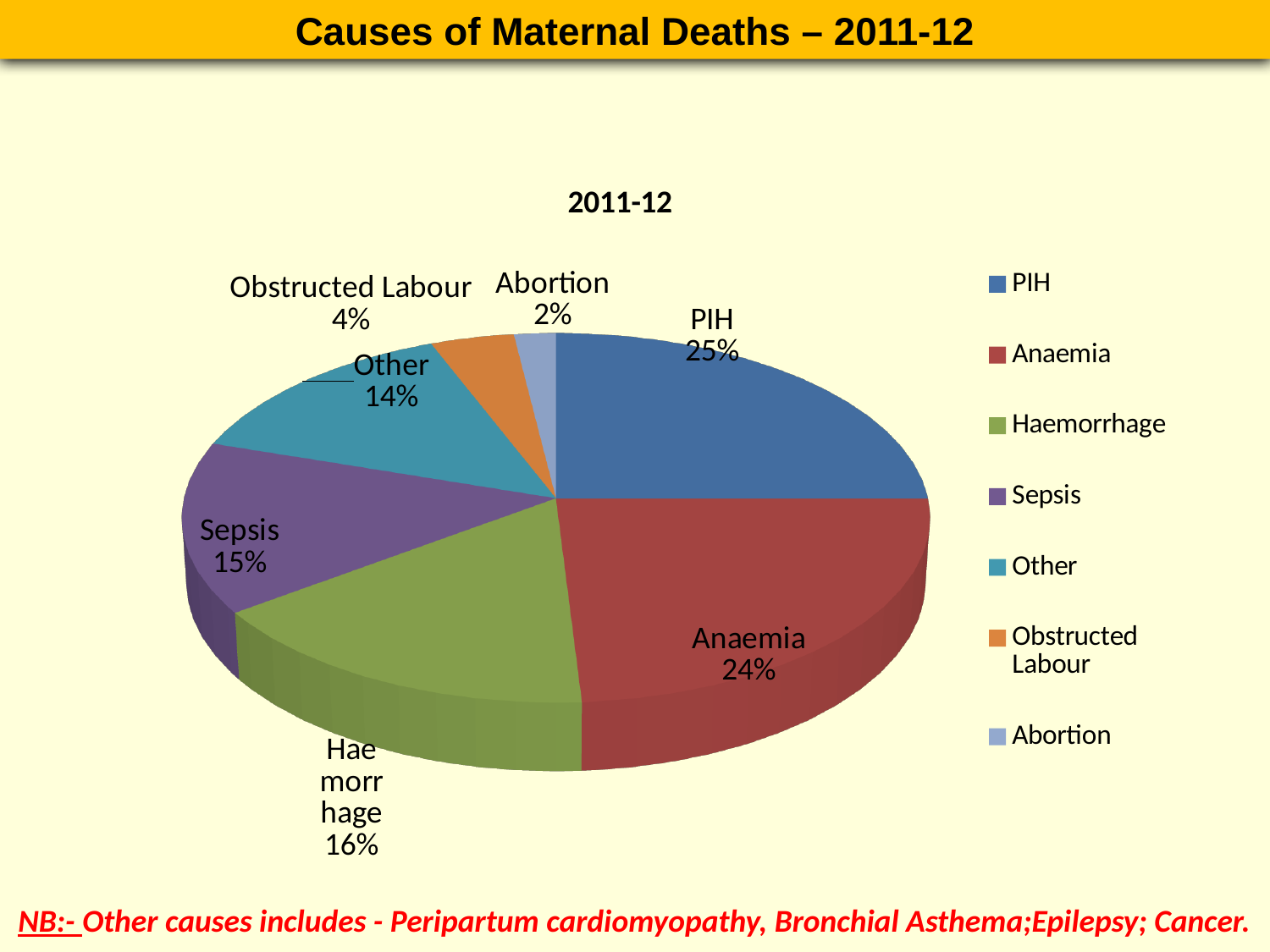
Which cause has the largest share of maternal deaths? PIH What percentage of maternal deaths is attributed to Obstructed Labour? 4% What percentage of maternal deaths is attributed to PIH? 25% What percentage is shown for Haemorrhage? 16% What percentage is shown for Sepsis? 15% What share of the pie does Anaemia account for? 24% Which cause has the smallest share of maternal deaths? Abortion What is the difference in percentage points between Sepsis and Other? 1% What is the title shown above the pie chart? 2011-12 How many causes are shown in the pie chart? 7 Which is larger, the share for Haemorrhage or the share for Obstructed Labour? Haemorrhage What kind of chart is shown on the slide? Pie chart